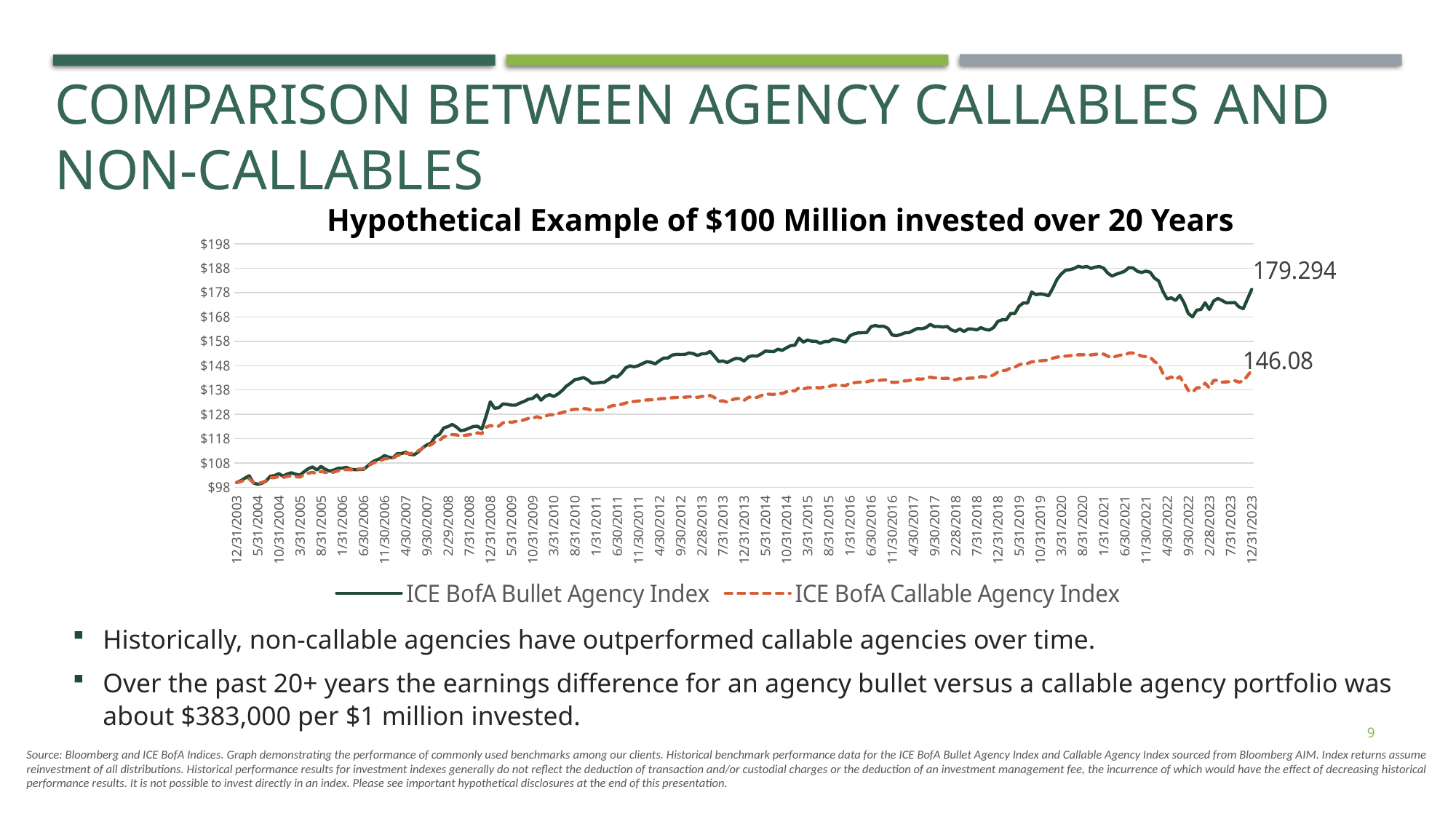
How many series does the chart's legend list? 2 What is the title of the chart? Hypothetical Example of $100 Million invested over 20 Years Which series is drawn with a dashed line in the chart? ICE BofA Callable Agency Index Is the final value of the ICE BofA Callable Agency Index greater or less than $158? less Is the value of the ICE BofA Bullet Agency Index around 3/31/2020 greater or less than $178? greater Is the value of the ICE BofA Callable Agency Index around 9/30/2022 greater or less than $148? less Overall, do the values of the ICE BofA Bullet Agency Index rise or fall from 12/31/2003 to 12/31/2023? Rise What kind of chart is shown on the slide? Line chart What is the difference between the final values of the ICE BofA Bullet Agency Index and the ICE BofA Callable Agency Index? 33.214 Which series ends higher at the end of the chart, the ICE BofA Bullet Agency Index or the ICE BofA Callable Agency Index? ICE BofA Bullet Agency Index What is the final value shown for the ICE BofA Bullet Agency Index at the end of the chart? 179.294 What is the final value shown for the ICE BofA Callable Agency Index at the end of the chart? 146.08